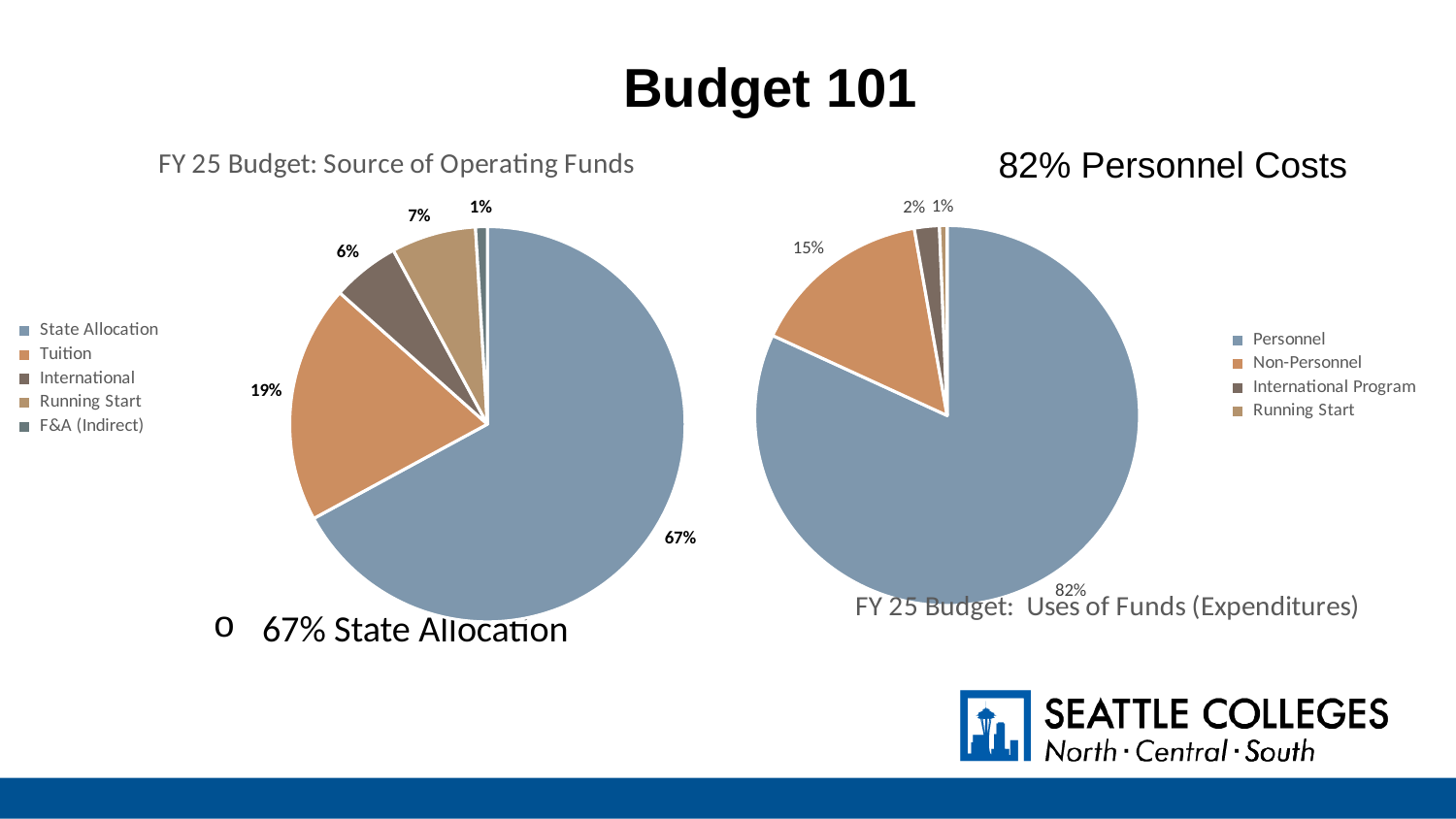
In the 'FY 25 Budget: Uses of Funds (Expenditures)' chart, how many categories does the legend list? 4 What type of chart is used for the 'FY 25 Budget: Uses of Funds (Expenditures)' chart? Pie chart In the 'FY 25 Budget: Uses of Funds (Expenditures)' chart, what share is Personnel? 82% In the 'FY 25 Budget: Uses of Funds (Expenditures)' chart, which category has the largest share? Personnel In the 'FY 25 Budget: Uses of Funds (Expenditures)' chart, which is larger, International Program or Running Start? International Program In the 'FY 25 Budget: Source of Operating Funds' chart, what share of funds comes from Tuition? 19% In the 'FY 25 Budget: Source of Operating Funds' chart, what share of funds comes from State Allocation? 67% In the 'FY 25 Budget: Source of Operating Funds' chart, how many categories does the legend list? 5 In the 'FY 25 Budget: Uses of Funds (Expenditures)' chart, what share is Non-Personnel? 15% In the 'FY 25 Budget: Source of Operating Funds' chart, what is the difference between the State Allocation and Tuition shares? 48% In the 'FY 25 Budget: Source of Operating Funds' chart, what share is Running Start? 7% In the 'FY 25 Budget: Source of Operating Funds' chart, which source has the smallest share? F&A (Indirect)